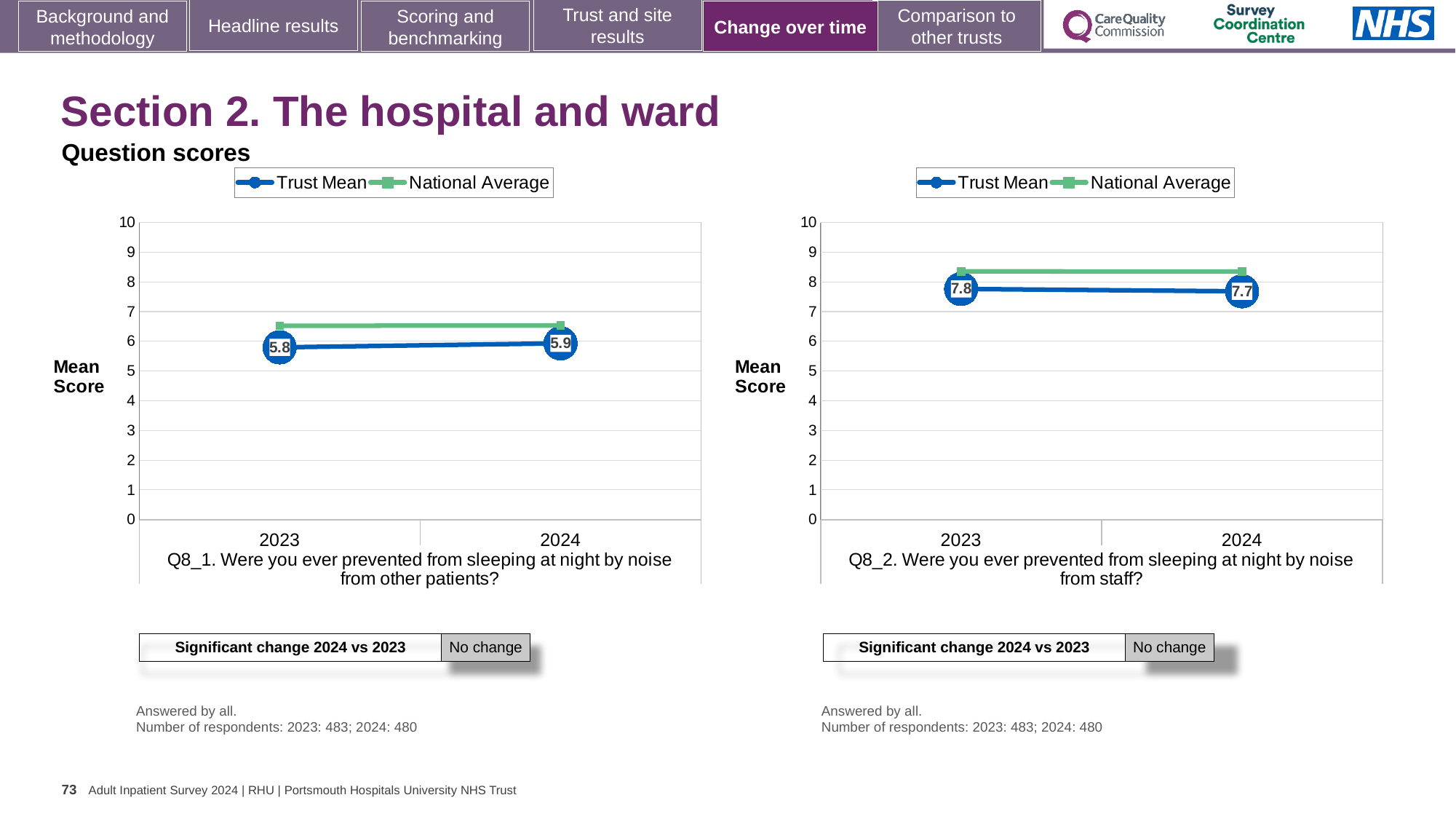
In the left chart (Q8_1, noise from other patients), what is the Trust Mean score for 2023? 5.8 In the left chart (Q8_1, noise from other patients), what is the Trust Mean score for 2024? 5.9 In the left chart (Q8_1), which is higher in 2024, the Trust Mean or the National Average? National Average In the left chart (Q8_1), by how much did the Trust Mean change from 2023 to 2024? 0.1 In the right chart (Q8_2), does the Trust Mean rise or fall from 2023 to 2024? fall In the right chart (Q8_2), is the National Average for 2024 greater or less than 8? greater In the right chart (Q8_2, noise from staff), what is the Trust Mean score for 2024? 7.7 In the left chart (Q8_1), is the National Average for 2023 greater or less than 6? greater What kind of chart is the left chart (Q8_1)? line chart In the right chart (Q8_2, noise from staff), what is the Trust Mean score for 2023? 7.8 In the left chart (Q8_1), does the Trust Mean rise or fall from 2023 to 2024? rise How many series does the legend of the right chart (Q8_2) list? 2